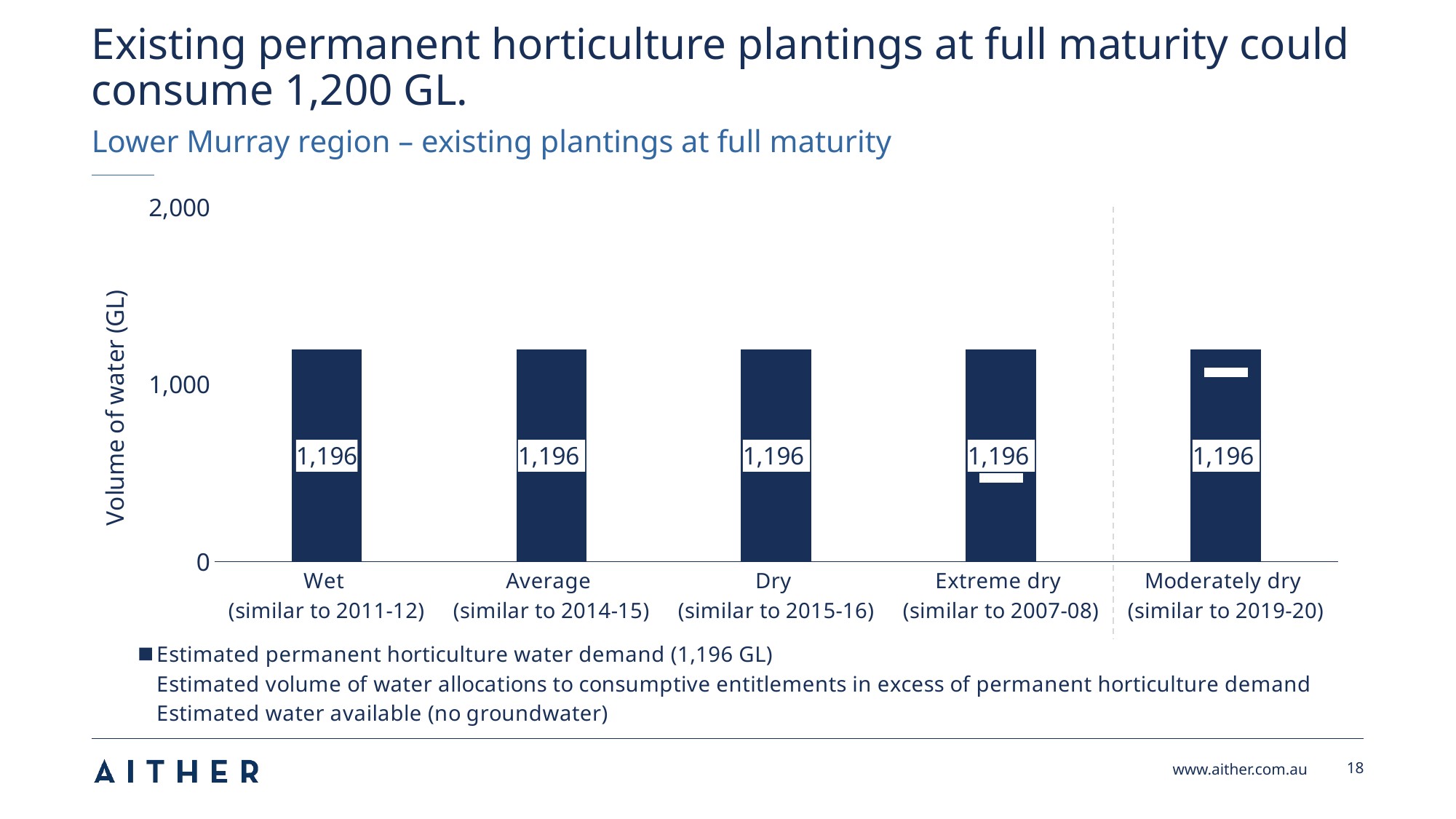
What is the label on the y axis of the chart? Volume of water (GL) What kind of chart is shown on the slide? bar chart How many climate scenarios are shown on the x axis of the chart? 5 Is the value for the Dry (similar to 2015-16) scenario greater or less than 2,000? less What is the estimated permanent horticulture water demand for the Wet (similar to 2011-12) scenario? 1,196 Do the labelled bar values rise, fall or stay the same across the scenarios from Wet to Moderately dry? stay the same What value is labelled on the bar for the Extreme dry (similar to 2007-08) scenario? 1,196 What is the subtitle of the chart shown on the slide? Lower Murray region – existing plantings at full maturity What is the difference between the labelled values for the Dry and Average scenarios? 0 How many entries does the chart legend list? 3 What value is labelled on the bar for the Moderately dry (similar to 2019-20) scenario? 1,196 Is the value for the Average (similar to 2014-15) scenario greater or less than 1,000? greater